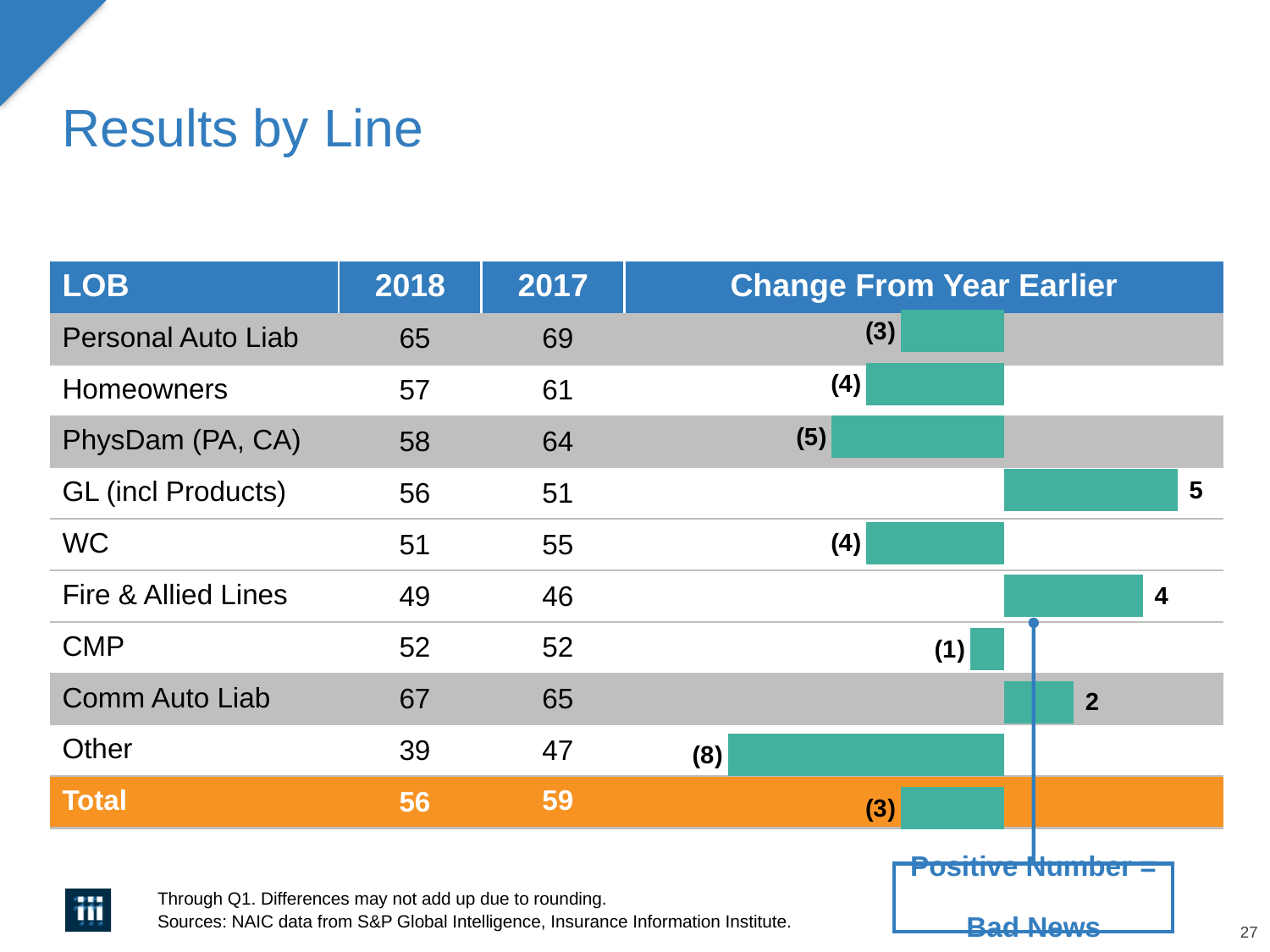
What is the title of the column containing the bar chart? Change From Year Earlier What is the Change From Year Earlier value for Other? (8) What is the Change From Year Earlier value for GL (incl Products)? 5 What kind of chart is shown in the Change From Year Earlier column? bar chart How many bars are shown in the Change From Year Earlier chart, including the Total row? 10 What is the difference between the Change From Year Earlier for GL (incl Products) and Fire & Allied Lines? 1 What is the Change From Year Earlier value for Comm Auto Liab? 2 Which line has the highest (most positive) Change From Year Earlier? GL (incl Products) What is the Change From Year Earlier value for Total? (3) Which line has the lowest (most negative) Change From Year Earlier? Other Which has the larger positive Change From Year Earlier, GL (incl Products) or Fire & Allied Lines? GL (incl Products) What is the Change From Year Earlier value for CMP? (1)